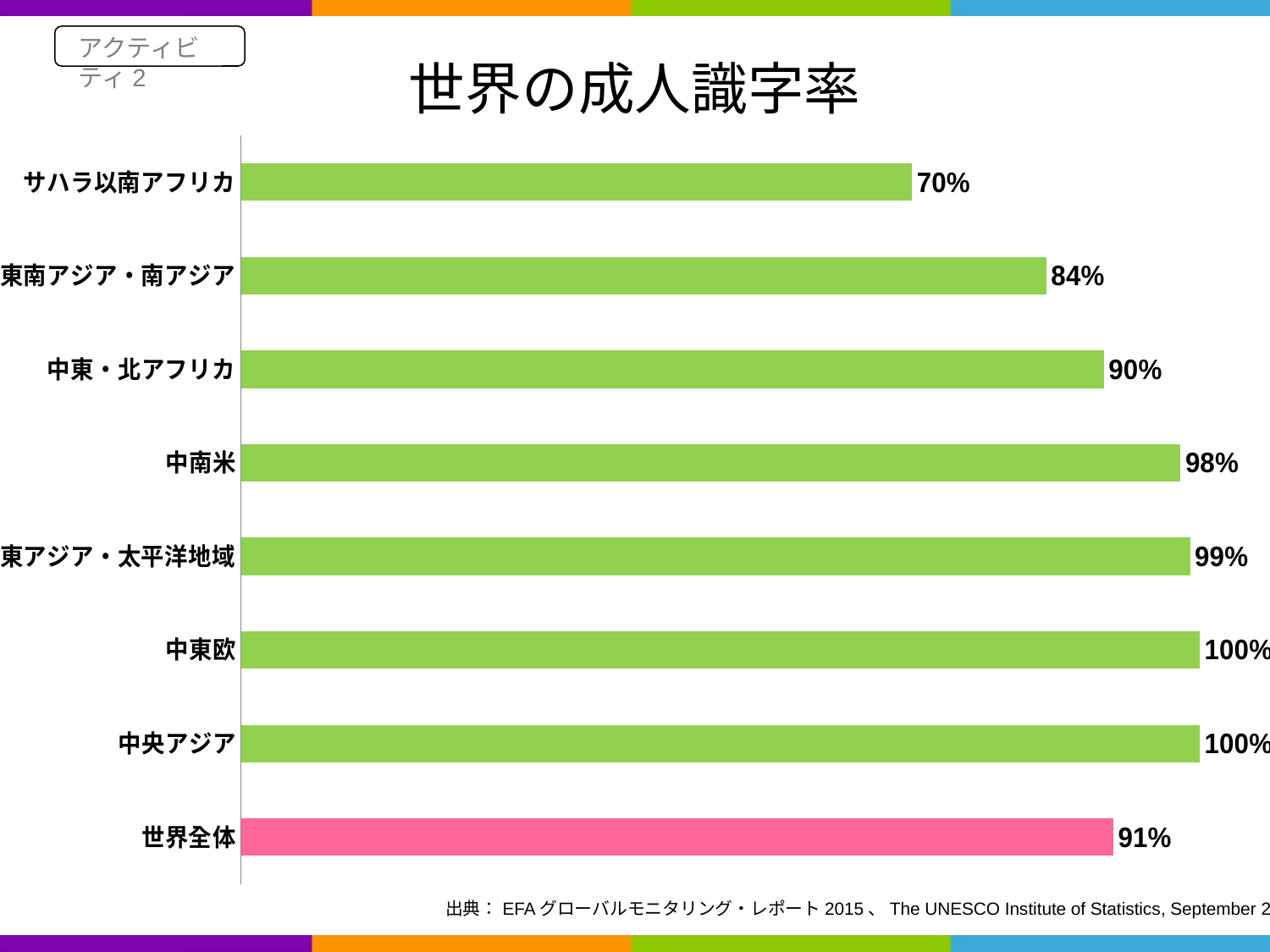
What is the value shown for 中南米? 98% Which category's bar is coloured pink instead of green? 世界全体 What kind of chart is shown on the slide? Bar chart What is the difference between the values for 中東・北アフリカ and サハラ以南アフリカ? 20% What is the difference between the values for 東アジア・太平洋地域 and 世界全体? 8% Which is larger, the value for 中東・北アフリカ or the value for 東南アジア・南アジア? 中東・北アフリカ What is the title of the chart? 世界の成人識字率 Which region has the lowest adult literacy rate on the chart? サハラ以南アフリカ How many categories are shown on the chart? 8 What is the adult literacy rate shown for サハラ以南アフリカ? 70% What is the value shown for 東南アジア・南アジア? 84% What is the value shown for 世界全体? 91%